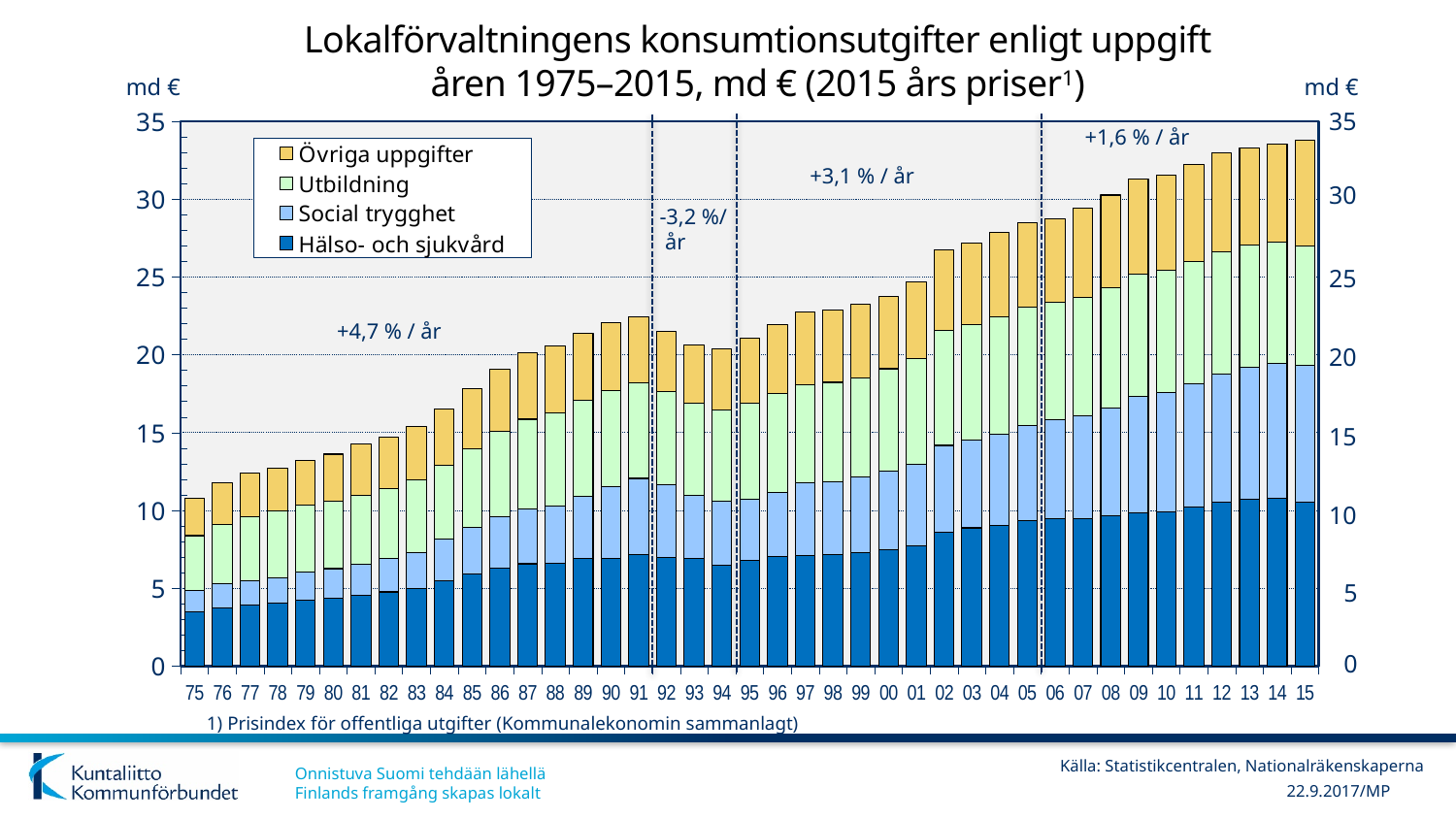
Is the total value for 1975 greater or less than 10? greater What kind of chart is shown on the slide? stacked bar chart Which is larger, the total for 2015 or the total for 1975? 2015 Is the Hälso- och sjukvård value for 1975 greater or less than 5? less Is the total value for 2015 greater or less than 30? greater Do the total values generally rise or fall from 1975 to 2015? rise What annual growth rate is annotated for the period 1991–1994? -3,2 %/år Which year has the lowest total consumption expenditure? 75 How many years (bars) are plotted on the x axis? 41 How many series does the legend list? 4